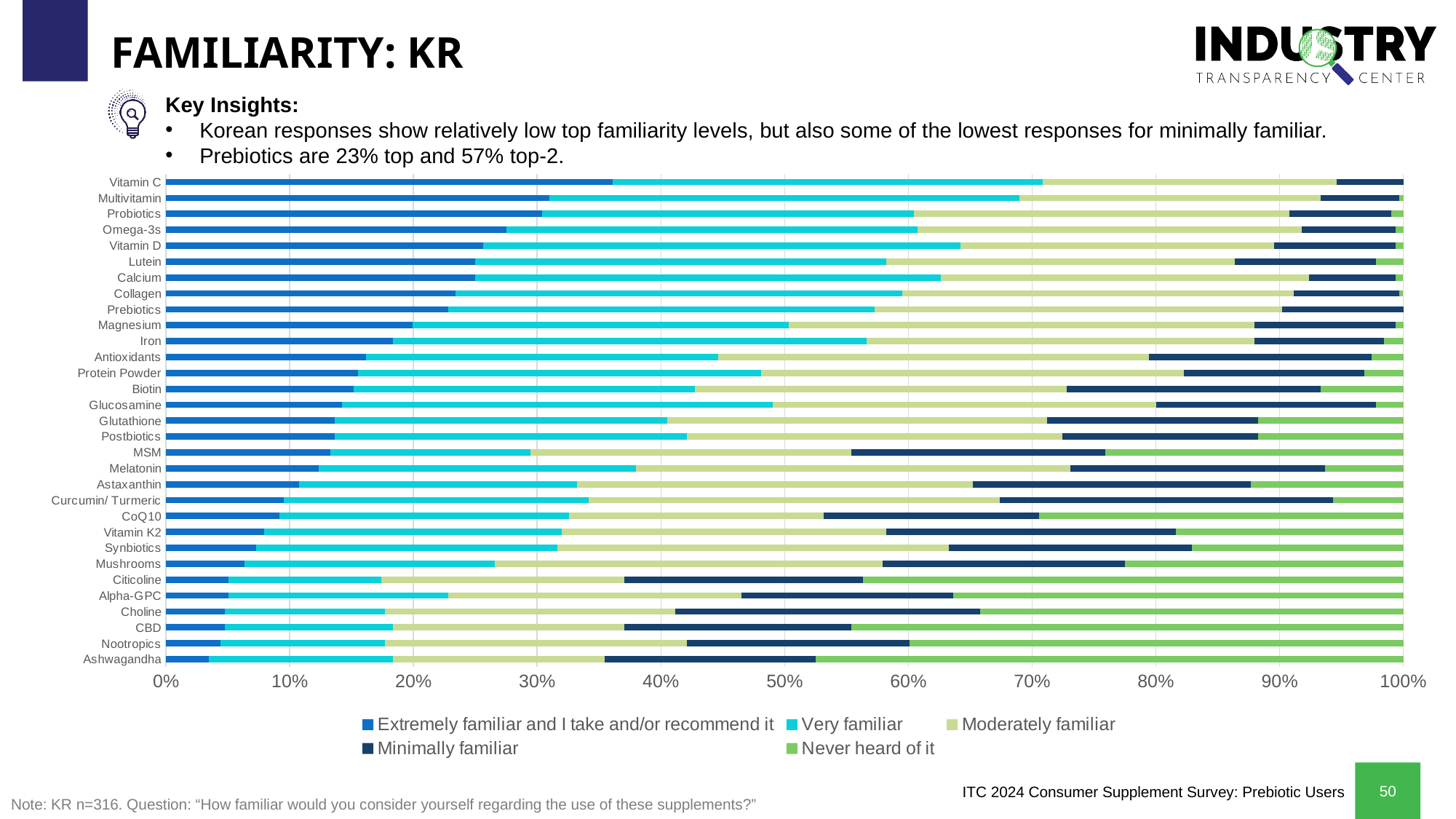
Which has a larger 'Never heard of it' segment, Ashwagandha or Vitamin C? Ashwagandha Moving down the list from Vitamin C to Ashwagandha, does the 'Extremely familiar and I take and/or recommend it' segment generally increase or decrease? decrease Which has a larger 'Extremely familiar and I take and/or recommend it' segment, Multivitamin or Mushrooms? Multivitamin Is the 'Extremely familiar and I take and/or recommend it' value for Ashwagandha greater or less than 10%? less What kind of chart is shown on the slide? Stacked bar chart Which legend entry is shown in dark navy? Minimally familiar How many supplement categories are listed on the chart? 31 Is the 'Extremely familiar and I take and/or recommend it' value for Vitamin C greater or less than 30%? greater Which supplement has the smallest 'Extremely familiar and I take and/or recommend it' segment? Ashwagandha Which supplement has the largest 'Extremely familiar and I take and/or recommend it' segment? Vitamin C How many series does the chart legend list? 5 According to the key insights, what is the top familiarity percentage for Prebiotics? 23%